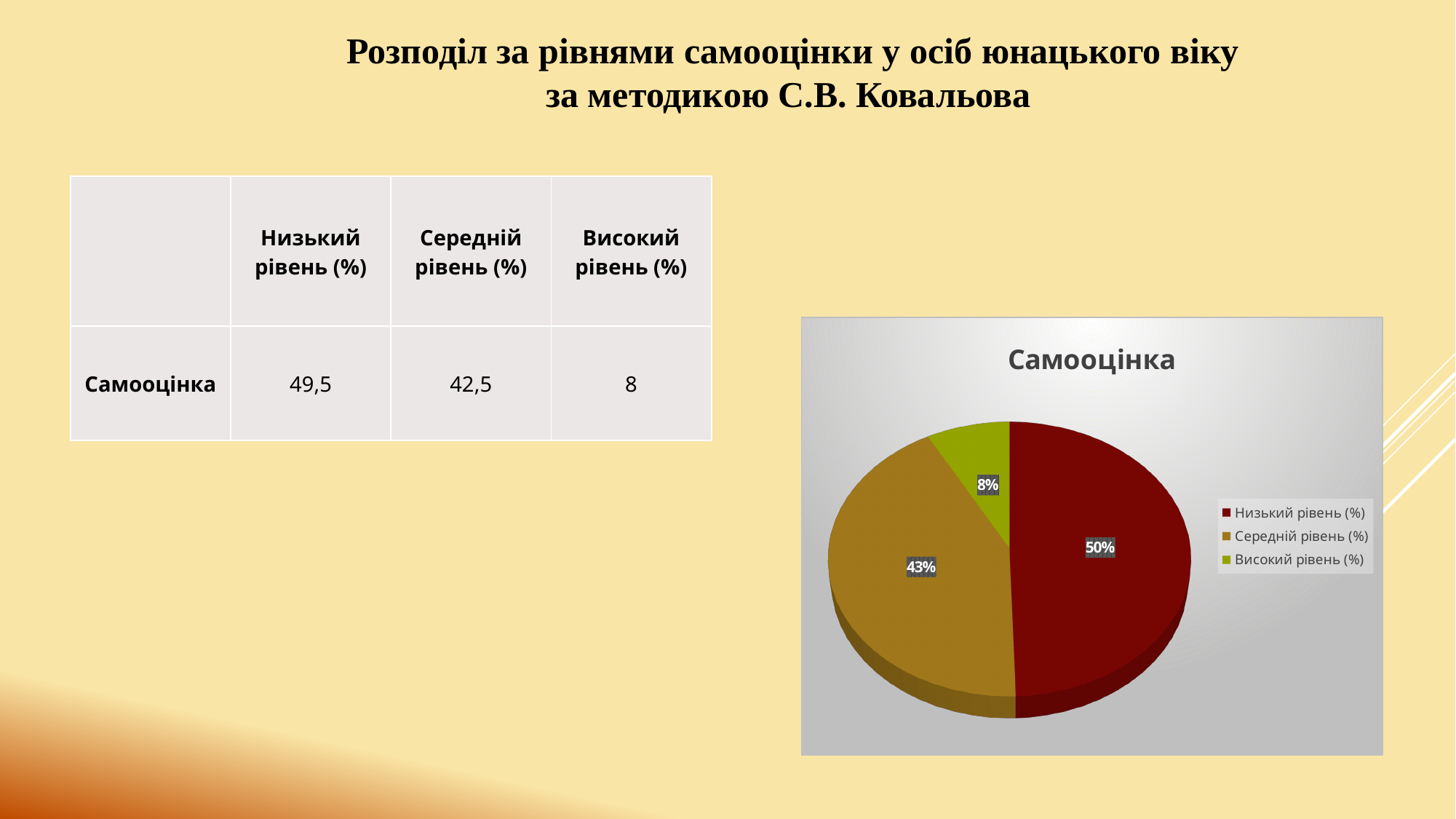
What share of the pie is labelled for Високий рівень (%)? 8% What share of the pie is labelled for Середній рівень (%)? 43% How many slices does the pie chart have? 3 What share of the pie is labelled for Низький рівень (%)? 50% What is the difference in percentage points between the Низький рівень (%) slice and the Високий рівень (%) slice as labelled on the chart? 42 Which slice of the pie chart is the largest? Низький рівень (%) How many entries does the chart legend list? 3 What kind of chart is shown on the slide? pie chart What colour is the Високий рівень (%) slice in the pie chart? green Which is larger in the pie chart: Середній рівень (%) or Високий рівень (%)? Середній рівень (%) Which slice of the pie chart is the smallest? Високий рівень (%) What is the title of the chart? Самооцінка